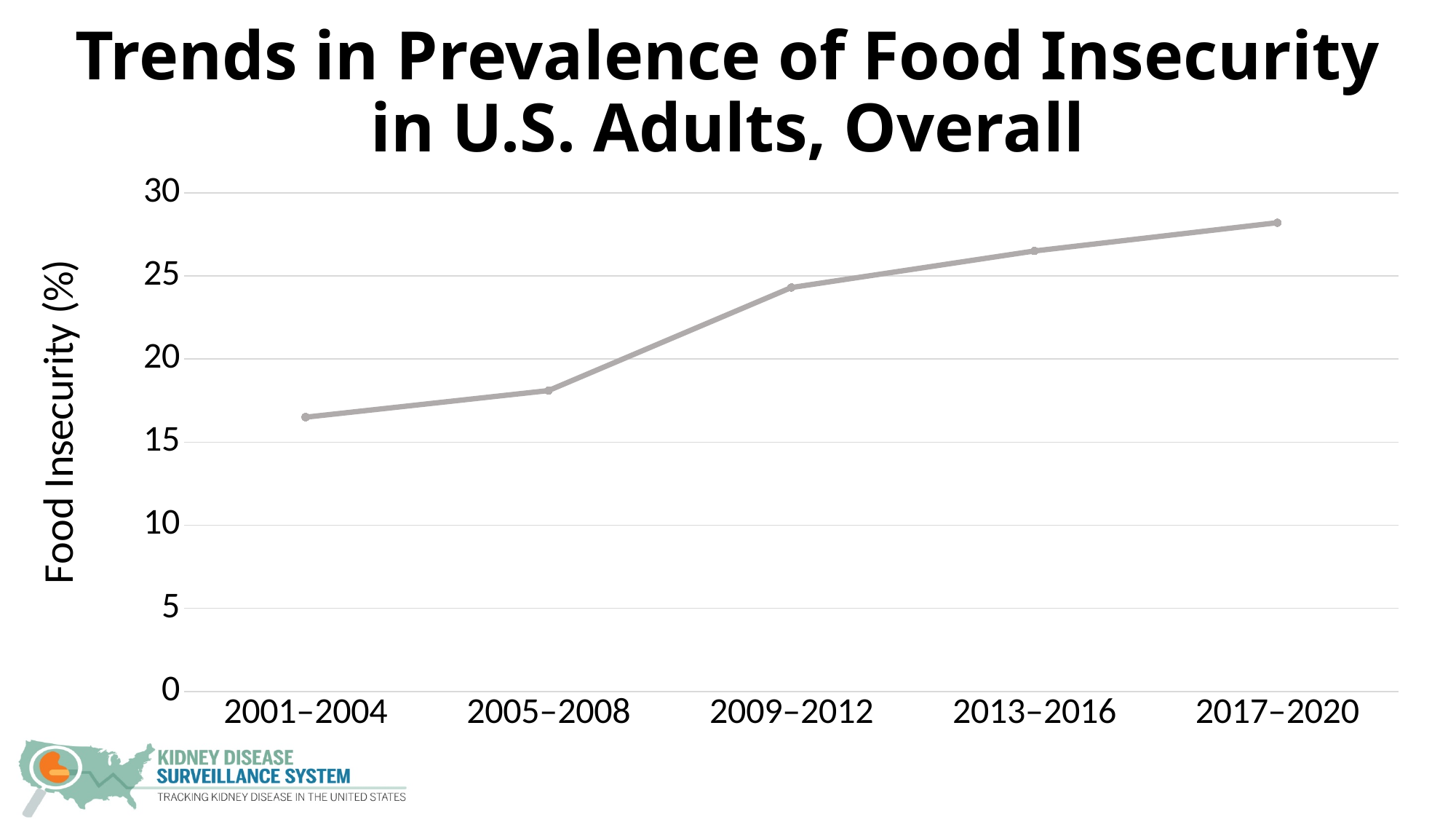
Do the values rise or fall from 2001–2004 to 2017–2020? rise How many time periods are plotted on the x axis? 5 Is the value for 2009–2012 greater or less than 20? greater What is the label of the y axis? Food Insecurity (%) What is the title of the chart? Trends in Prevalence of Food Insecurity in U.S. Adults, Overall Is the value for 2005–2008 greater or less than 20? less Which is larger, the value for 2009–2012 or the value for 2005–2008? 2009–2012 Which period has the highest food insecurity prevalence? 2017–2020 Is the value for 2017–2020 greater or less than 30? less What kind of chart is shown on the slide? line chart Which period has the lowest food insecurity prevalence? 2001–2004